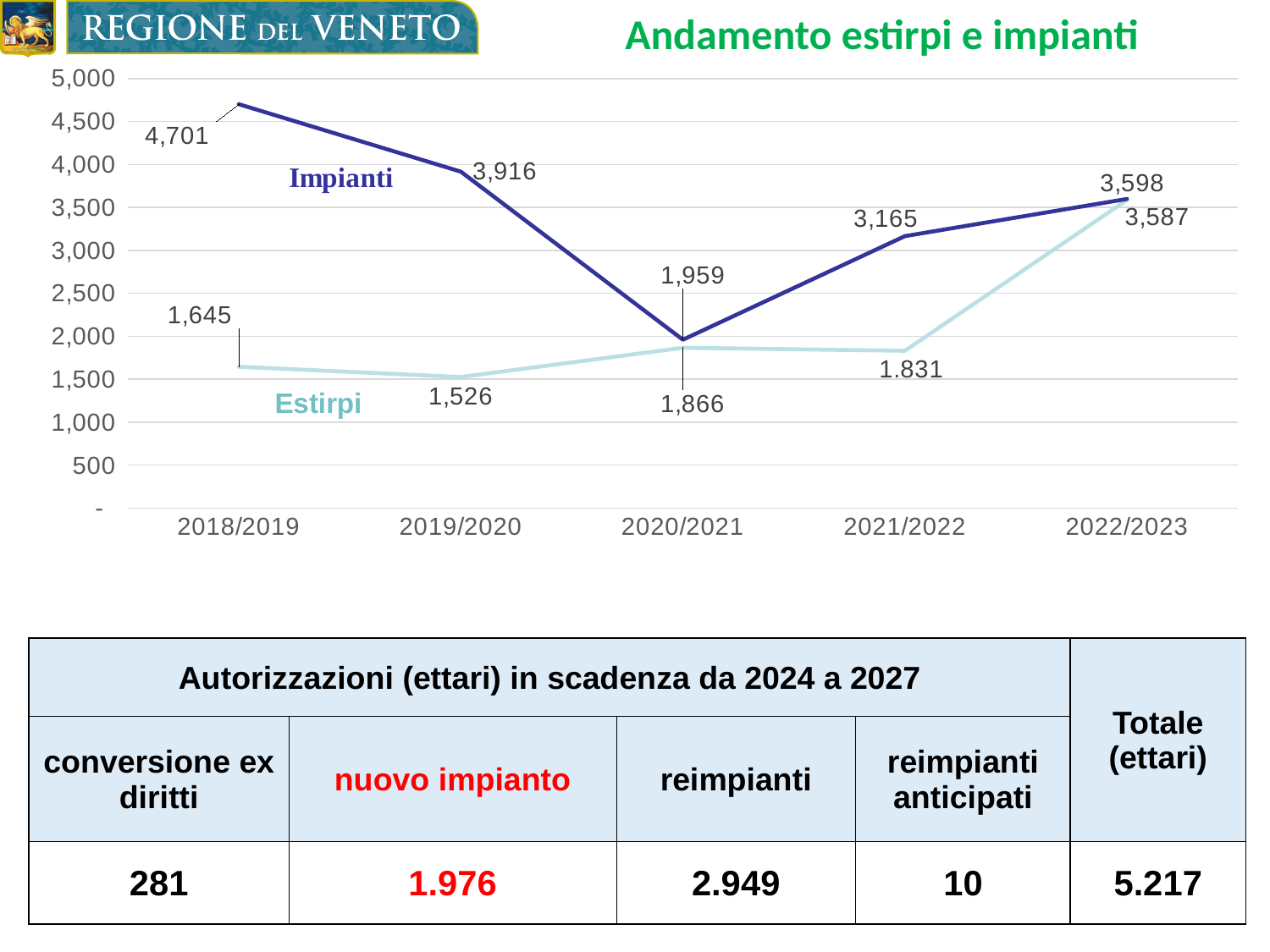
Which is larger in 2019/2020, Impianti or Estirpi? Impianti What is the Estirpi value for 2022/2023? 3,587 What is the Impianti value for 2021/2022? 3,165 In which season is the Impianti value highest? 2018/2019 Is the Estirpi value for 2019/2020 greater or less than 2,000? less What kind of chart is shown on the slide? line chart What is the difference between the Impianti values for 2018/2019 and 2019/2020? 785 What is the Impianti value for 2018/2019? 4,701 In which season is the Impianti value lowest? 2020/2021 What is the Estirpi value for 2019/2020? 1,526 How many seasons are shown on the x axis? 5 In which season is the Estirpi value lowest? 2019/2020